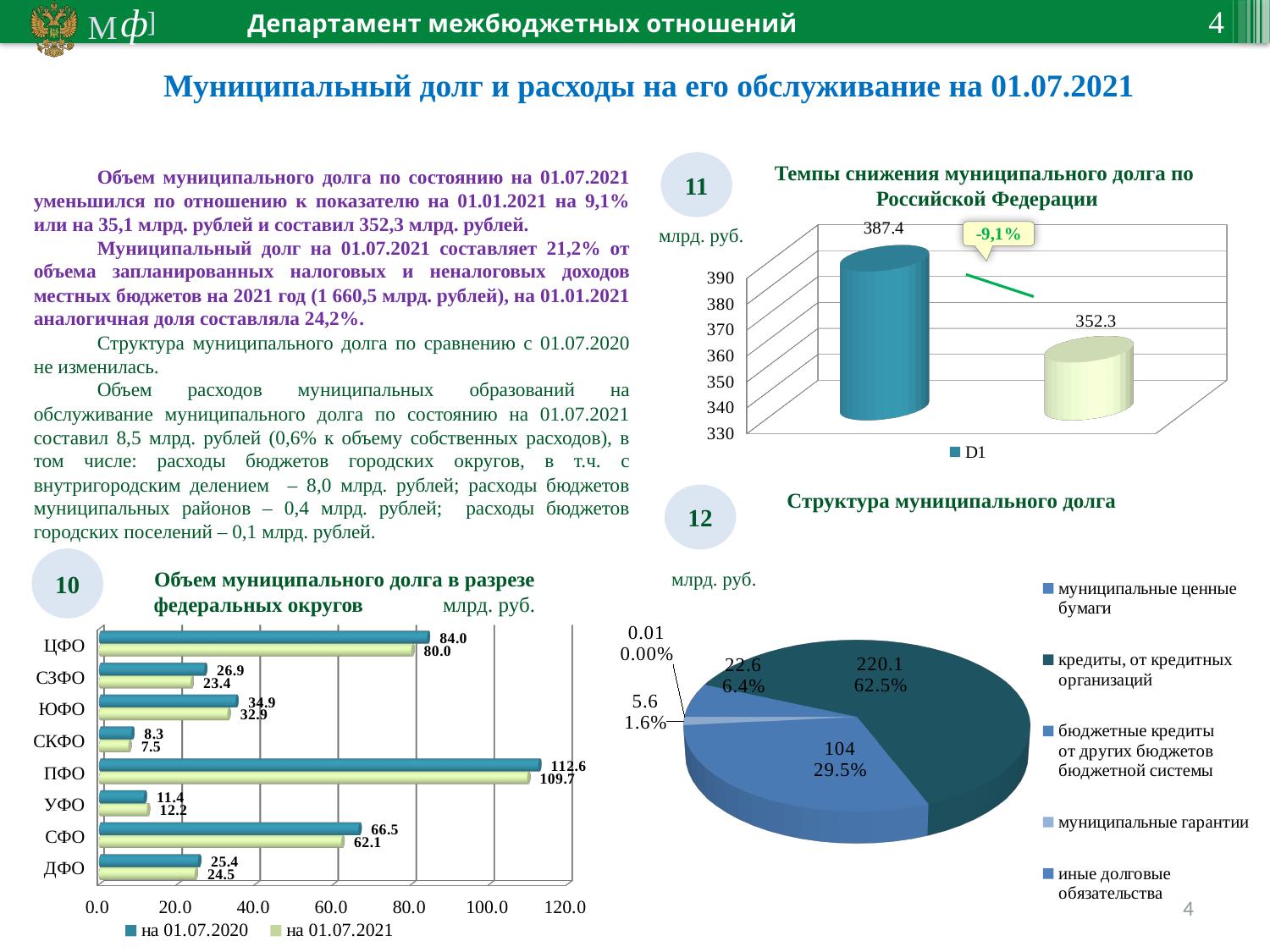
How many federal districts are shown in the chart 'Объем муниципального долга в разрезе федеральных округов'? 8 In the chart 'Объем муниципального долга в разрезе федеральных округов', which federal district has the highest value on 01.07.2020? ПФО In the chart 'Объем муниципального долга в разрезе федеральных округов', what is the difference between the ЦФО values on 01.07.2020 and 01.07.2021? 4.0 In the pie chart 'Структура муниципального долга', what share does the largest slice (220.1) represent? 62.5% In the chart 'Объем муниципального долга в разрезе федеральных округов', what is the value for ПФО on 01.07.2021? 109.7 How many series does the legend list in the chart 'Объем муниципального долга в разрезе федеральных округов'? 2 In the chart 'Темпы снижения муниципального долга по Российской Федерации', what is the value of the second (lighter) bar? 352.3 What kind of chart is 'Темпы снижения муниципального долга по Российской Федерации'? bar chart In the chart 'Объем муниципального долга в разрезе федеральных округов', for УФО, which is larger: the value on 01.07.2020 or on 01.07.2021? на 01.07.2021 In the chart 'Объем муниципального долга в разрезе федеральных округов', which federal district has the lowest value on 01.07.2021? СКФО In the pie chart 'Структура муниципального долга', what percentage is shown for the slice with value 104? 29.5% In the chart 'Темпы снижения муниципального долга по Российской Федерации', what is the difference between the two bars? 35.1